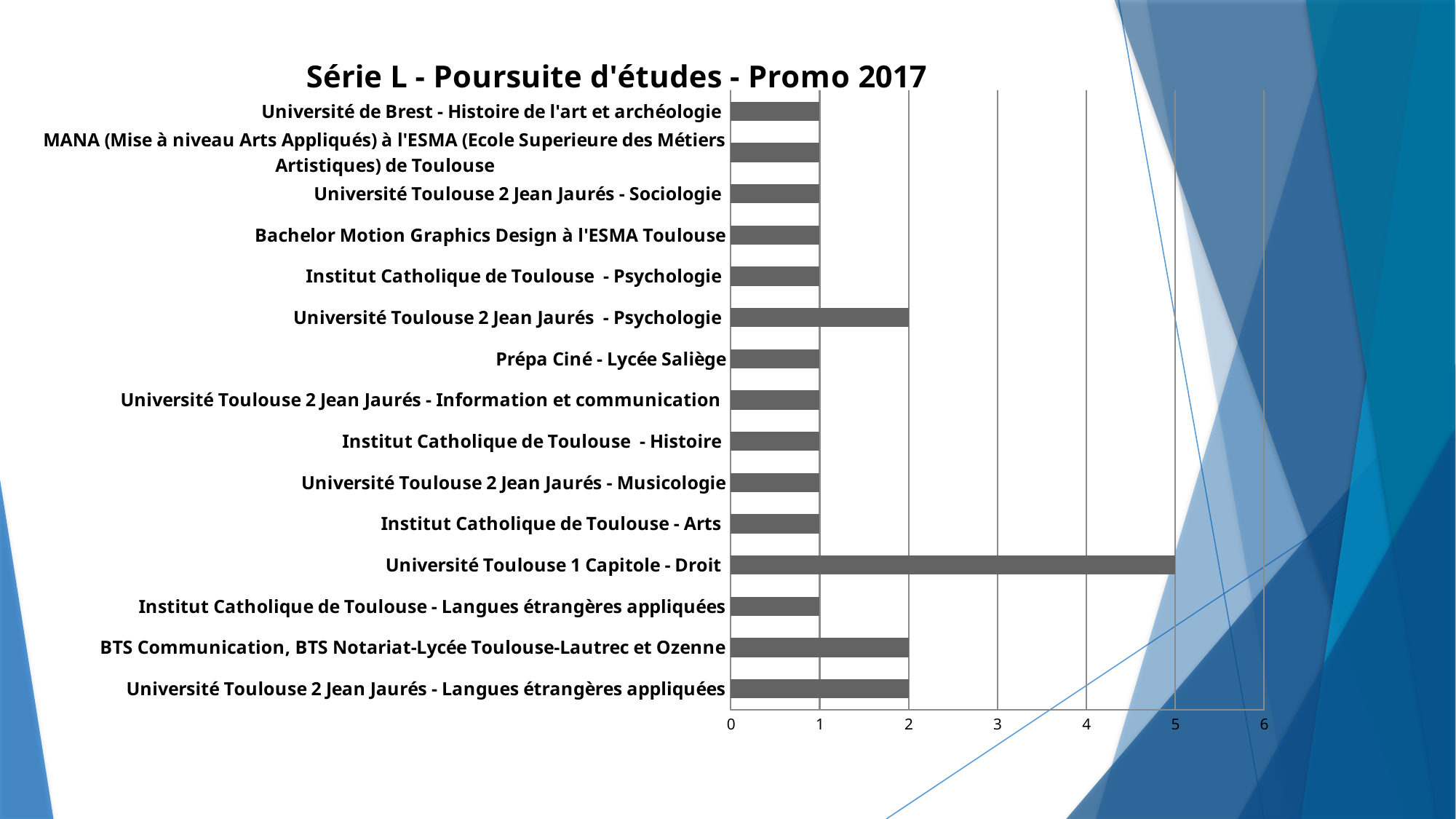
Which category has the highest value? Université Toulouse 1 Capitole - Droit What is the value for BTS Communication, BTS Notariat-Lycée Toulouse-Lautrec et Ozenne? 2 How many categories are shown in the chart? 15 What is the value for Université Toulouse 1 Capitole - Droit? 5 What is the value for Prépa Ciné - Lycée Saliège? 1 What is the difference between the values for Université Toulouse 1 Capitole - Droit and Université Toulouse 2 Jean Jaurés - Langues étrangères appliquées? 3 What is the title of the chart? Série L - Poursuite d'études - Promo 2017 Which is larger: the value for Université Toulouse 2 Jean Jaurés - Psychologie or the value for Institut Catholique de Toulouse - Psychologie? Université Toulouse 2 Jean Jaurés - Psychologie What is the value for Université Toulouse 2 Jean Jaurés - Psychologie? 2 What type of chart is shown on the slide? Bar chart What is the maximum value shown on the horizontal axis? 6 Is the value for Université Toulouse 1 Capitole - Droit greater or less than 4? greater